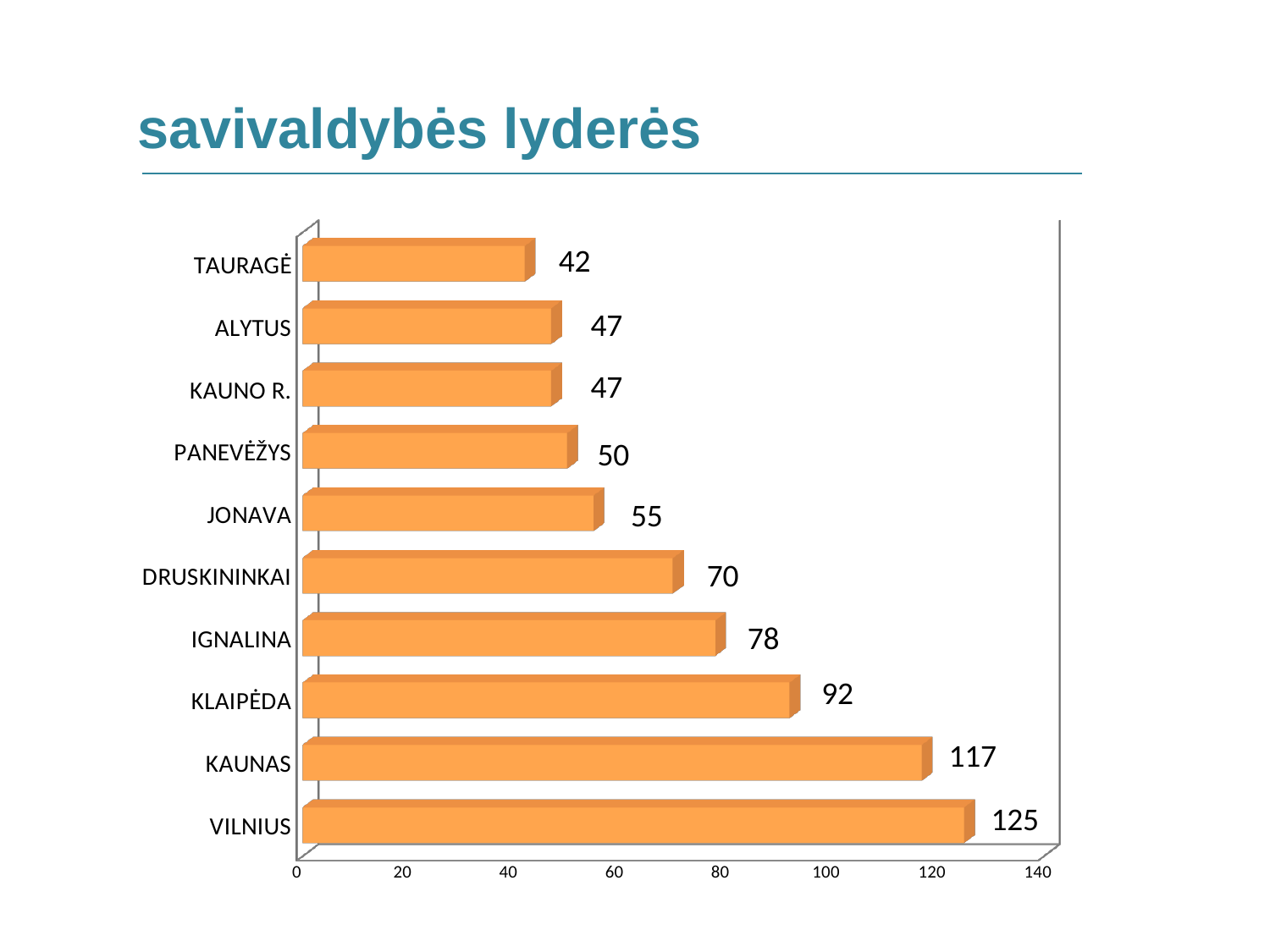
What is the value for DRUSKININKAI? 70 What is the value for KLAIPĖDA? 92 What is the difference between the values for VILNIUS and KAUNAS? 8 What is the difference between the values for IGNALINA and JONAVA? 23 Which is larger, the value for KLAIPĖDA or the value for IGNALINA? KLAIPĖDA How many categories are shown in the chart? 10 What is the value for VILNIUS? 125 Which category has the highest value? VILNIUS What kind of chart is shown on the slide? bar chart What is the title of the slide? savivaldybės lyderės Which category has the lowest value? TAURAGĖ Is the value for KAUNAS greater or less than 100? greater